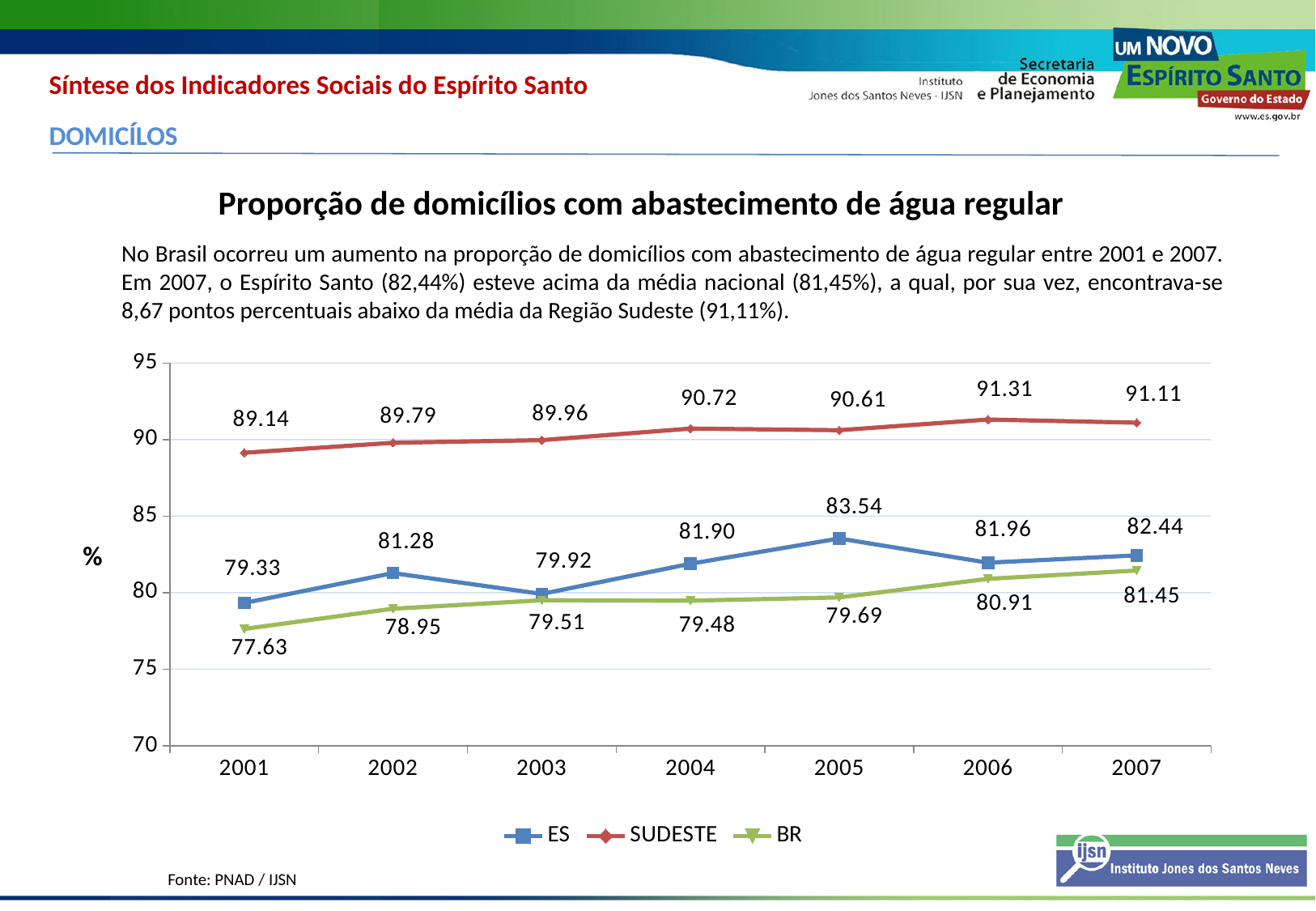
In which year does the BR series have its lowest value? 2001 What type of chart is shown on the slide? line chart Which series has the larger value in 2003, ES or BR? ES What is the value for SUDESTE in 2004? 90.72 In which year does the ES series reach its highest value? 2005 Does the BR series generally rise or fall from 2001 to 2007? rise What is the value for ES in 2005? 83.54 How many series does the legend list? 3 How many years are shown on the x axis? 7 Is the value for SUDESTE in 2001 greater or less than 85? greater What is the difference between the SUDESTE and BR values in 2007? 9.66 What is the value for BR in 2001? 77.63